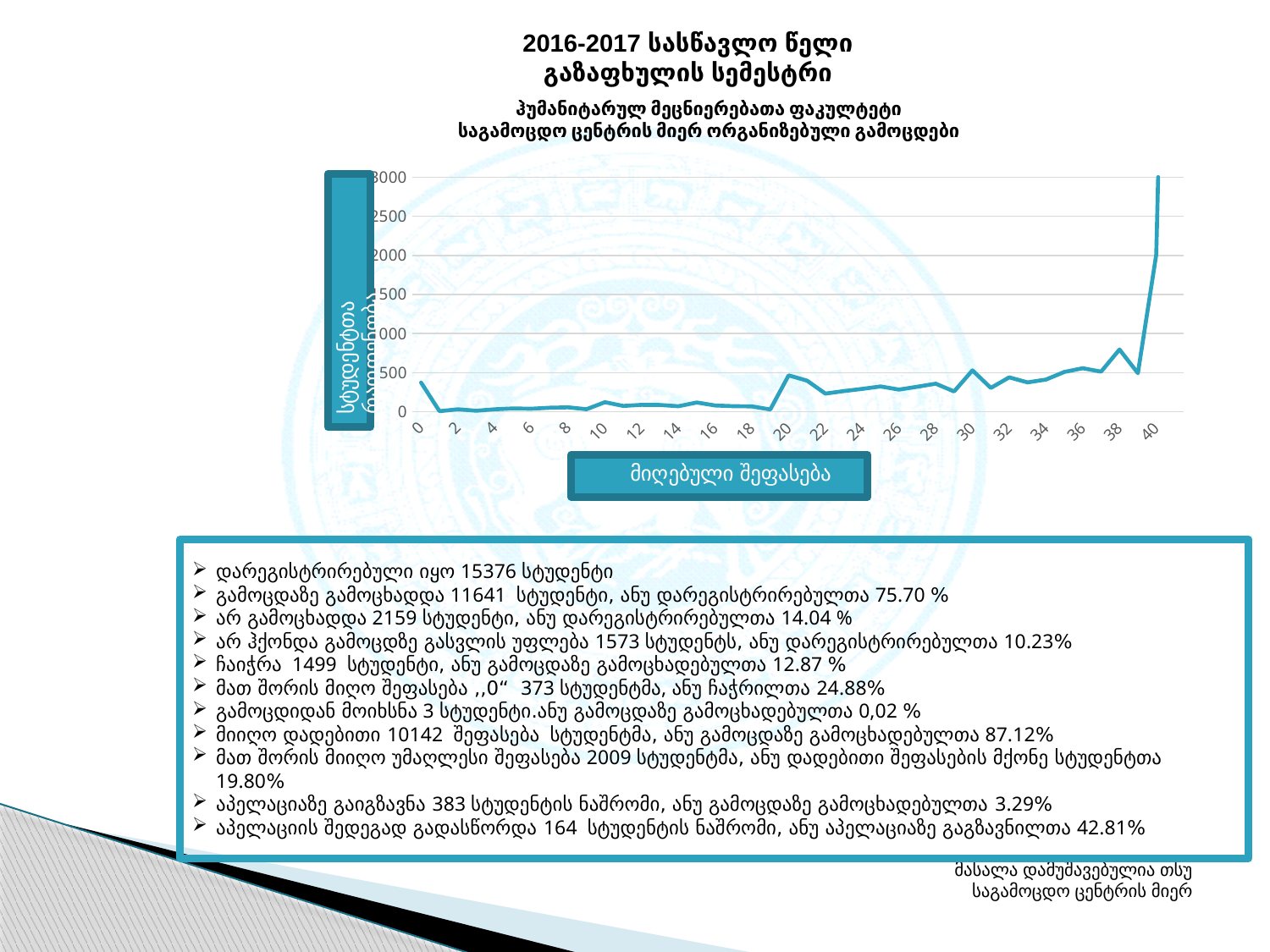
Is the value of the line at x = 0 greater or less than 500? less Which has the larger value on the line, x = 37 or x = 10? 37 Is the value of the line at x = 10 greater or less than 500? less What is the highest tick value shown on the vertical axis of the chart? 3000 Overall, does the line rise or fall as the x-axis values increase from 0 to 40? rise At which x-axis value does the line reach its highest point? 40 What kind of chart is shown on the slide? line chart Which has the larger value on the line, x = 40 or x = 0? 40